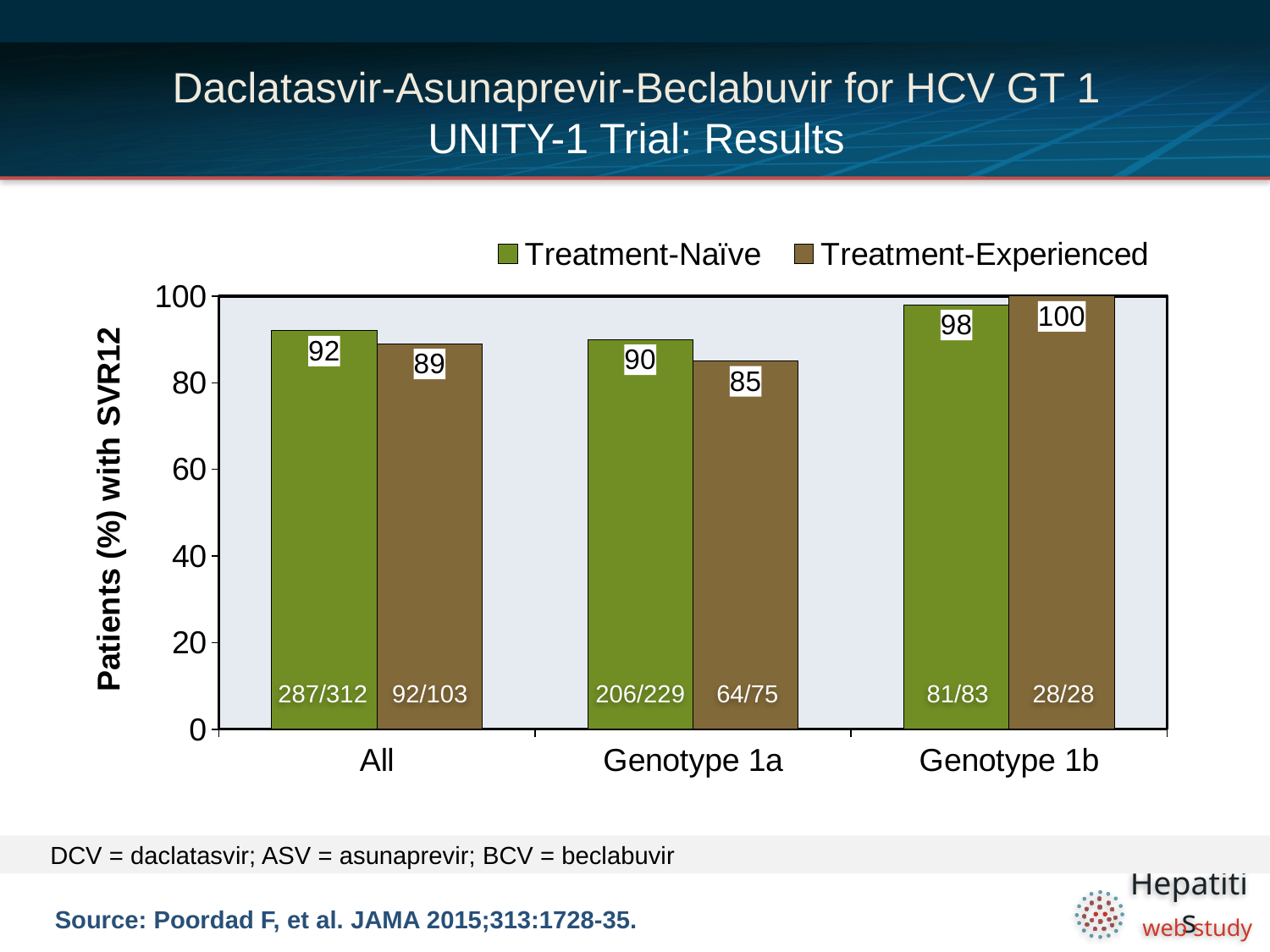
How many series does the legend list? 2 What is the SVR12 rate for Treatment-Naïve patients in the All group? 92 What is the SVR12 rate for Treatment-Experienced patients with Genotype 1a? 85 Which category has the highest SVR12 rate for Treatment-Naïve patients? Genotype 1b How many categories are shown on the x axis? 3 What fraction of patients is shown for the Treatment-Naïve bar in the Genotype 1a group? 206/229 What is the label of the y axis? Patients (%) with SVR12 Which is larger in the All group: the Treatment-Naïve or the Treatment-Experienced SVR12 rate? Treatment-Naïve Which category has the lowest SVR12 rate for Treatment-Experienced patients? Genotype 1a What kind of chart is shown on the slide? Bar chart What is the SVR12 rate for Treatment-Experienced patients with Genotype 1b? 100 What is the difference between the Treatment-Naïve and Treatment-Experienced SVR12 rates in the Genotype 1a group? 5